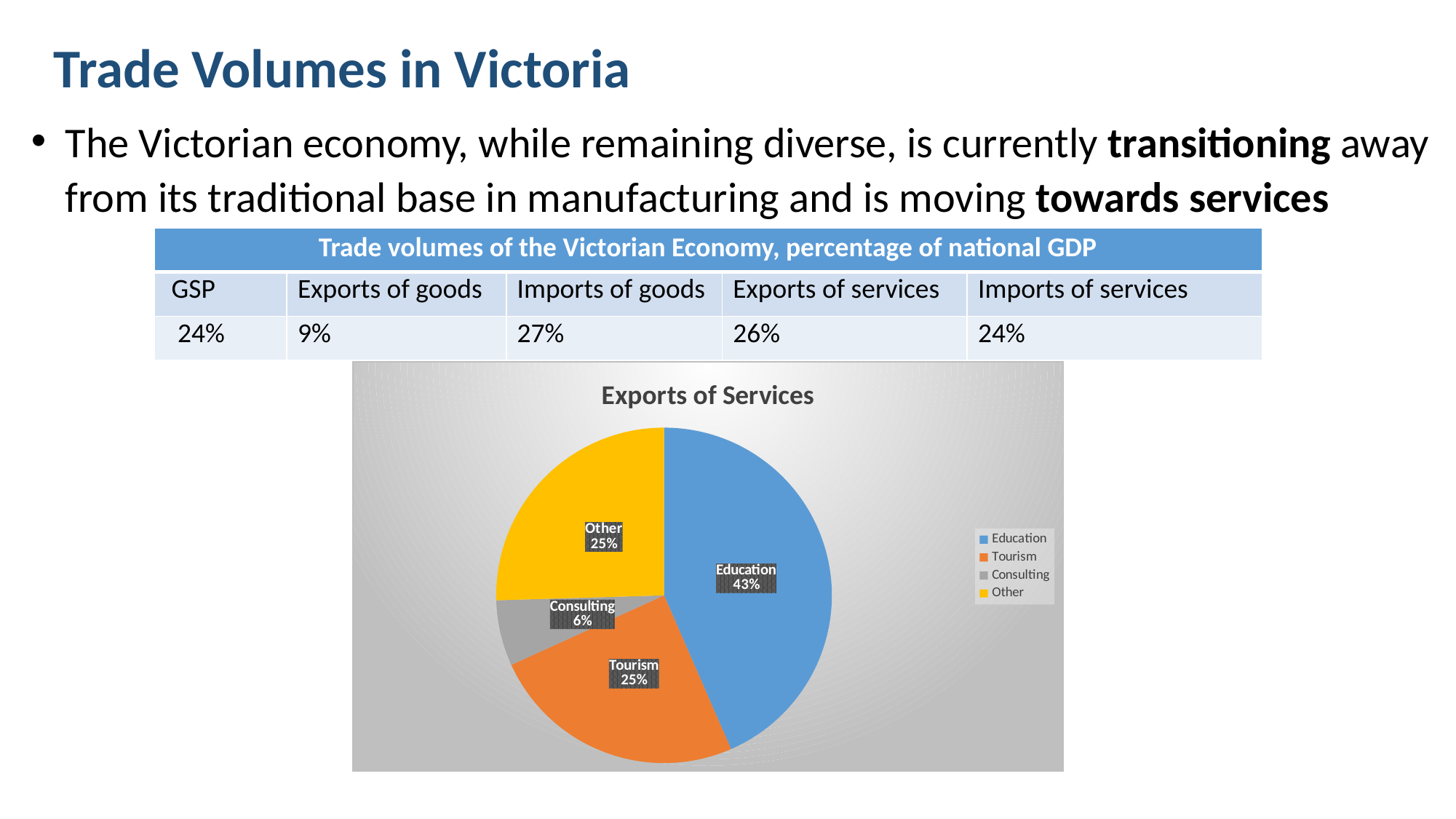
How many categories does the pie chart have? 4 What is the title of the chart? Exports of Services What share of the pie does Consulting represent? 6% What share of the pie does Education represent? 43% Which category has the largest slice of the pie? Education What share of the pie does Other represent? 25% What colour is the Consulting slice in the pie chart? Grey Which category has the smallest slice of the pie? Consulting What share of the pie does Tourism represent? 25% What type of chart is shown on the slide? Pie chart Which is larger, the Education slice or the Other slice? Education What is the difference in percentage points between Education and Tourism? 18